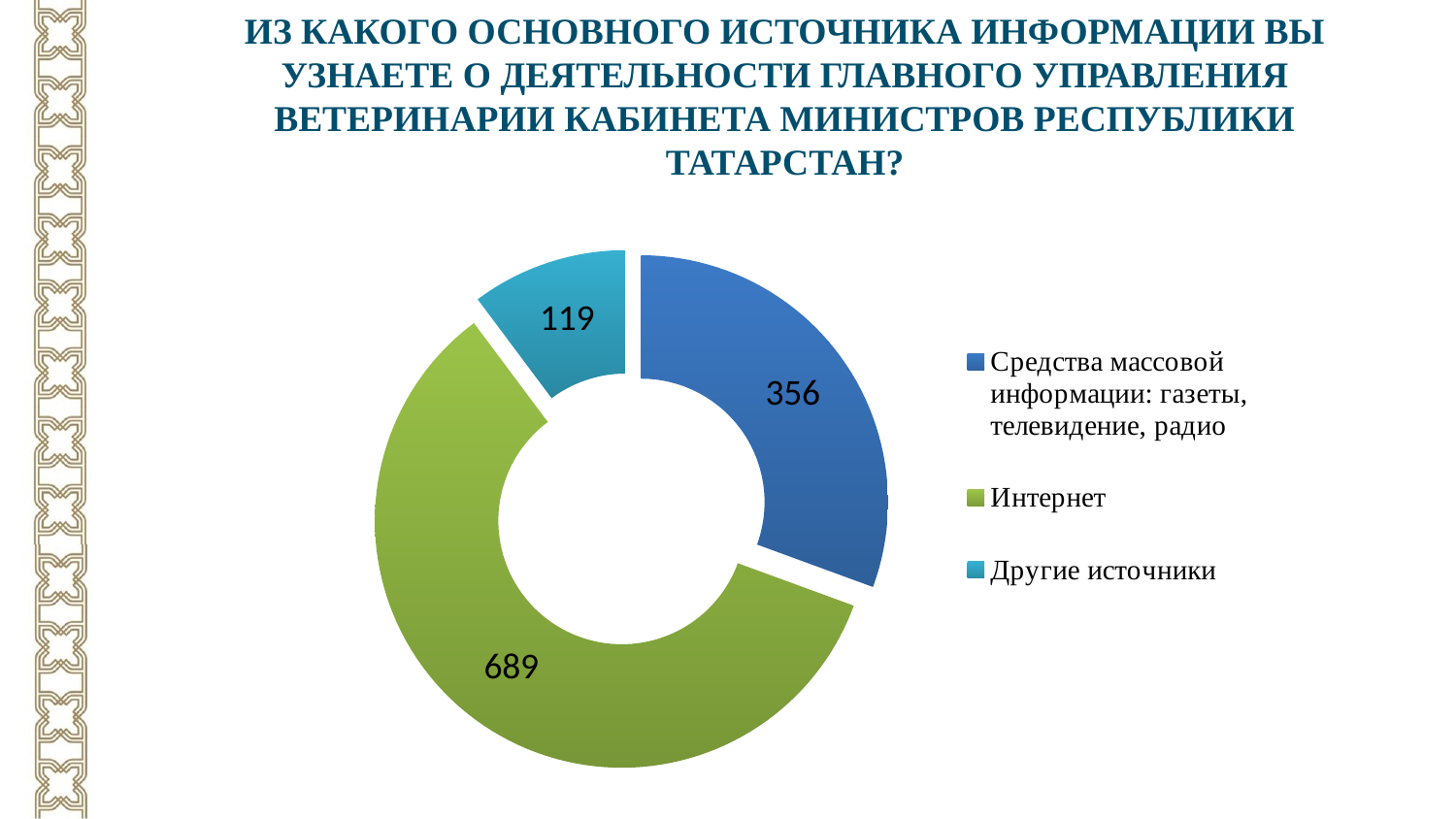
Which category has the smallest value? Другие источники What value is shown for Другие источники? 119 What is the difference between the values for Средства массовой информации and Другие источники? 237 How many categories does the chart show? 3 What value is shown for Средства массовой информации: газеты, телевидение, радио? 356 What kind of chart is shown on the slide? doughnut chart Which colour represents Другие источники in the chart? light blue (teal) What is the difference between the values for Интернет and Средства массовой информации? 333 Which category has the largest value? Интернет What value is shown for Интернет? 689 What is the total of all three values shown in the chart? 1164 Which is larger, the value for Интернет or the value for Средства массовой информации? Интернет